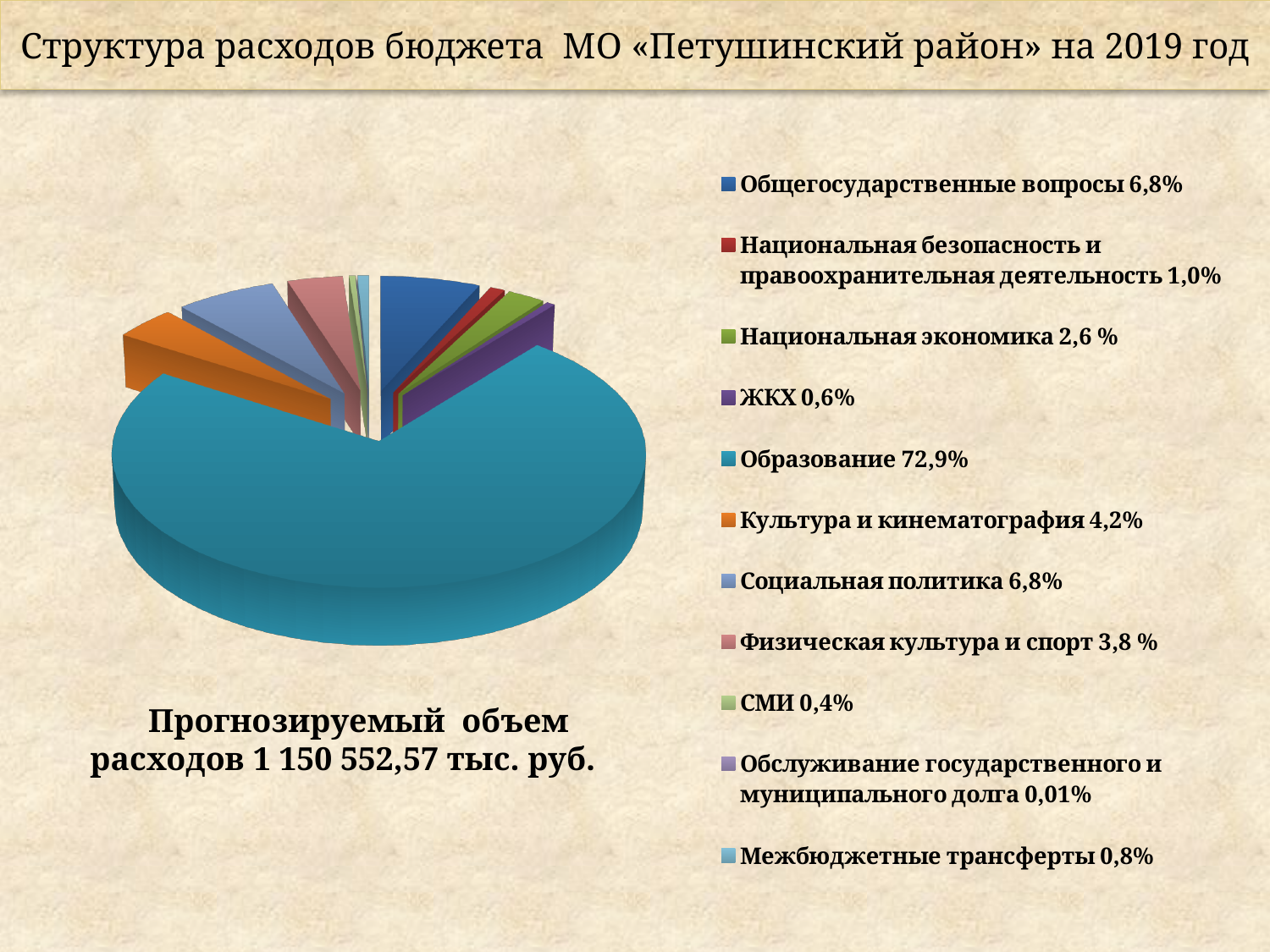
What share of expenditures goes to Физическая культура и спорт? 3,8 % Which category has the smallest share of the budget expenditures? Обслуживание государственного и муниципального долга How many categories does the legend of the pie chart list? 11 Which category has the largest share of the budget expenditures? Образование What is the title of the slide? Структура расходов бюджета МО «Петушинский район» на 2019 год What kind of chart is shown on the slide? pie chart What share of expenditures goes to Образование? 72,9% What is the difference in percentage points between the share for Социальная политика and the share for Культура и кинематография? 2,6 Which is larger: the share for Национальная экономика or the share for ЖКХ? Национальная экономика What is the forecast total volume of expenditures stated below the pie chart? 1 150 552,57 тыс. руб. What share of expenditures goes to Культура и кинематография? 4,2% What share of expenditures goes to Межбюджетные трансферты? 0,8%